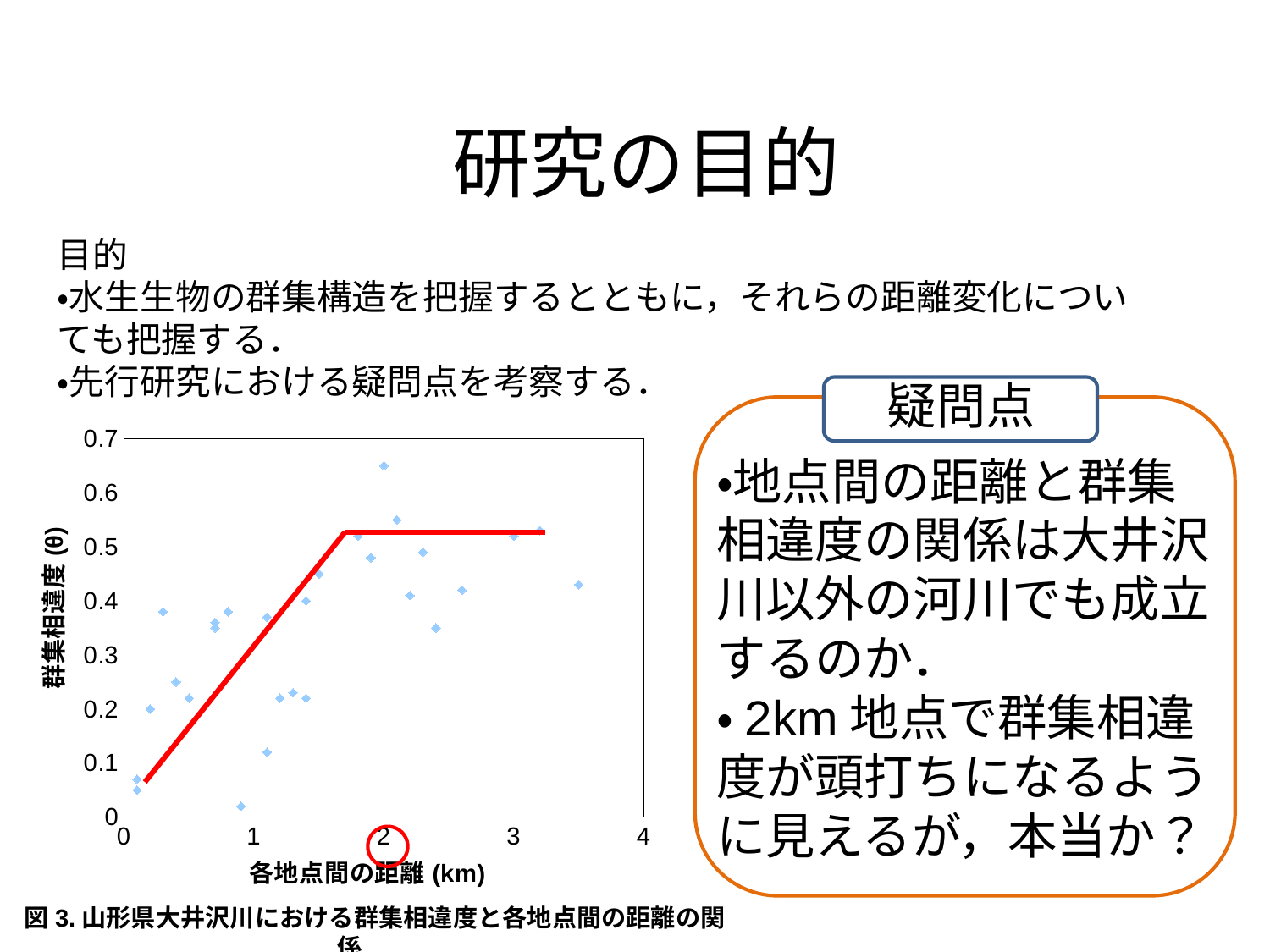
Is the plotted point at about 3.5 km greater or less than 0.5? less Is the lowest plotted point in the chart (near 0.9 km) greater or less than 0.1? less What is the title of the x axis of the chart? 各地点間の距離 (km) What is the title of the y axis of the chart? 群集相違度 (θ) Which x-axis tick value is circled in red on the chart? 2 Does the red line in the chart rise or fall as distance increases from 0 km to about 1.7 km? rise Is the highest plotted point in the chart (near 2 km) greater or less than 0.6? greater What kind of chart is shown on the slide? scatter chart